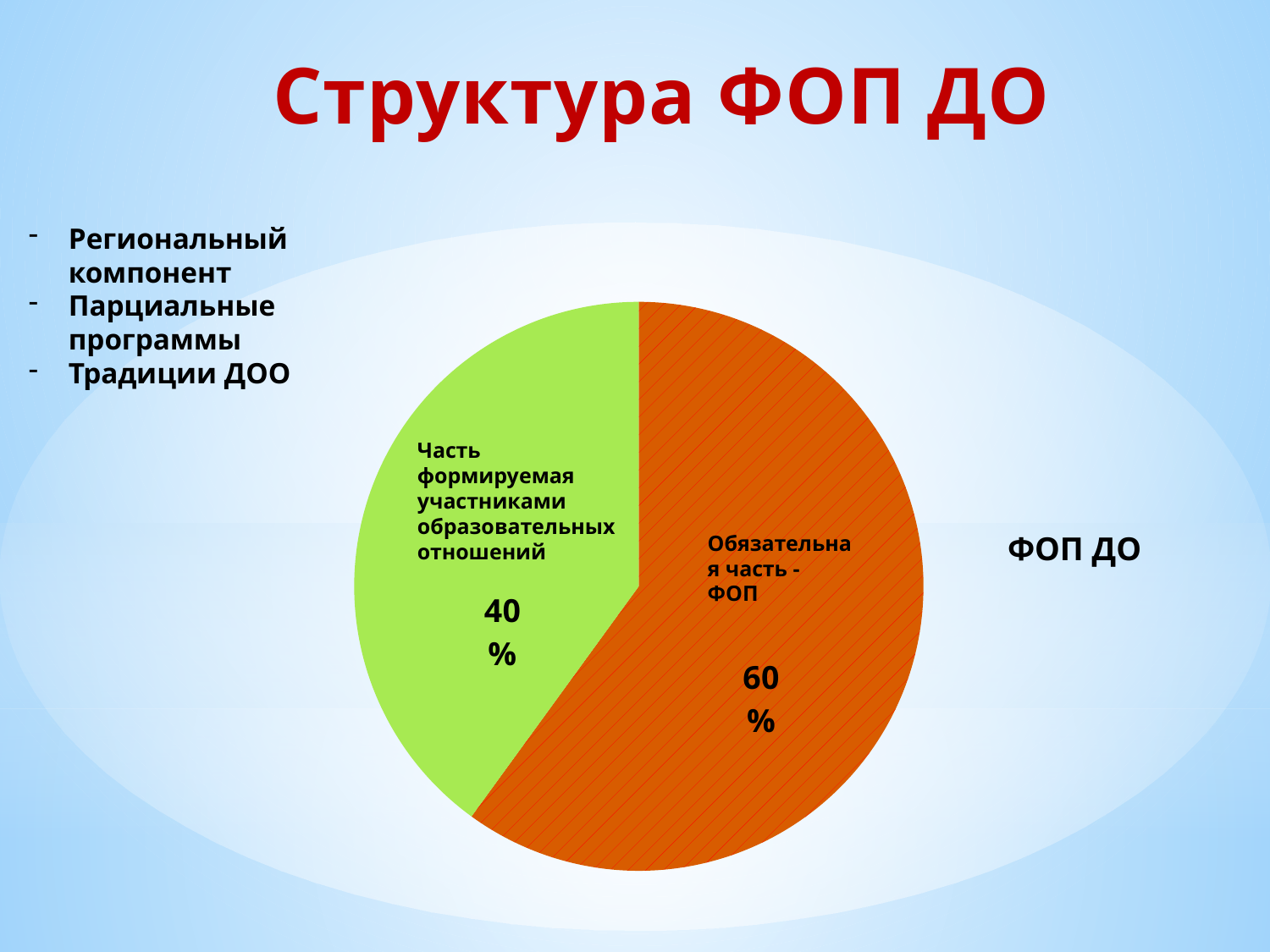
What is the difference in percentage points between the "Обязательная часть - ФОП" slice and the "Часть формируемая участниками образовательных отношений" slice? 20 What share of the pie does "Часть формируемая участниками образовательных отношений" have? 40% What colour is the "Обязательная часть - ФОП" slice? orange How many slices does the pie chart have? 2 Which is larger: the "Обязательная часть - ФОП" slice or the "Часть формируемая участниками образовательных отношений" slice? Обязательная часть - ФОП What is the title of the slide containing the pie chart? Структура ФОП ДО What share of the pie does "Обязательная часть - ФОП" have? 60% Which slice of the pie is the smallest? Часть формируемая участниками образовательных отношений Which slice of the pie is the largest? Обязательная часть - ФОП What kind of chart is shown on the slide? pie chart